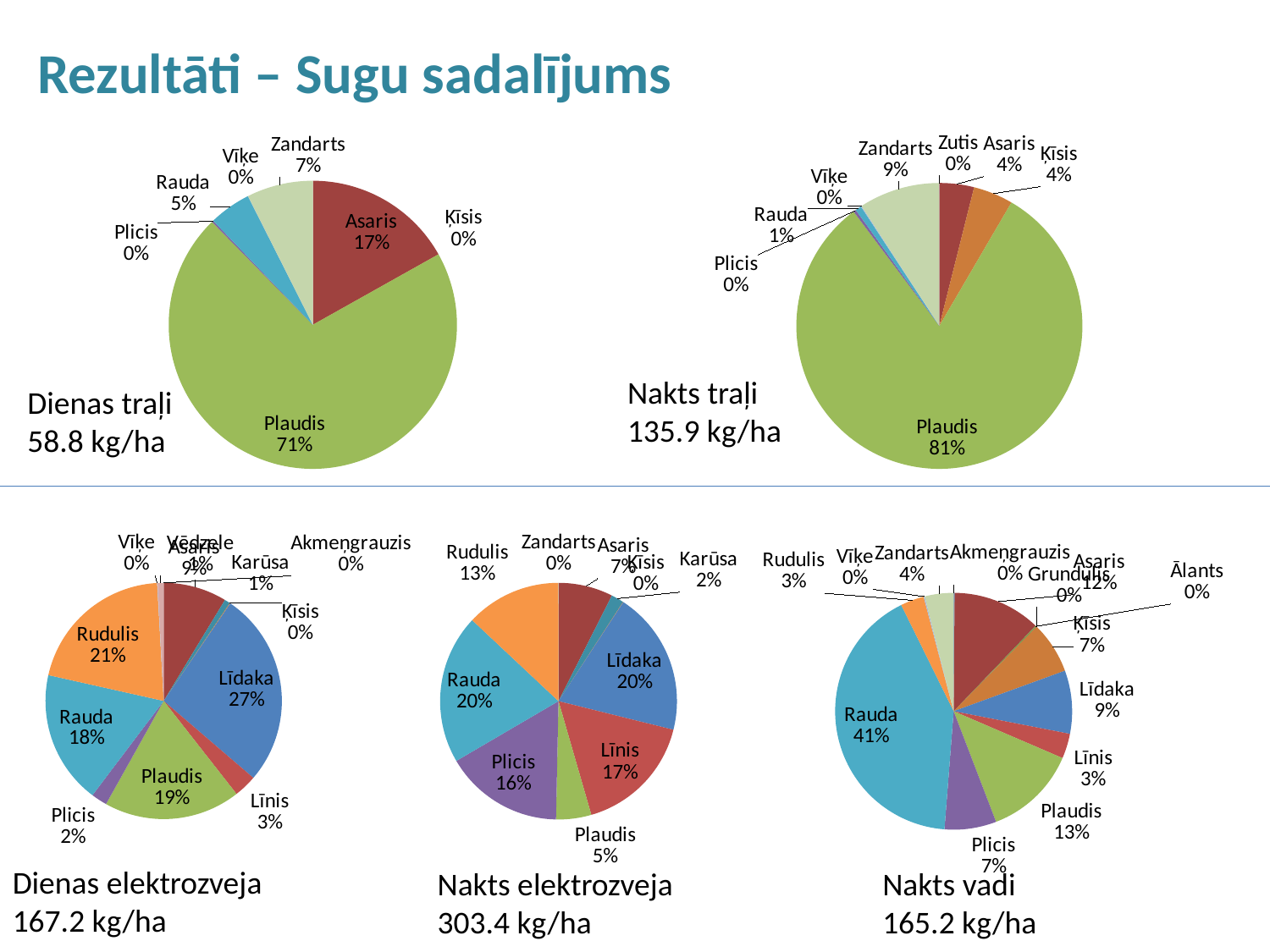
What kind of charts are shown on the slide? Pie charts What total catch in kg/ha is given for 'Nakts elektrozveja'? 303.4 kg/ha In the 'Dienas elektrozveja' pie chart, what is the difference between the shares of Rudulis and Rauda? 3% In the 'Dienas elektrozveja' pie chart, which species has the largest share? Līdaka In the 'Nakts vadi' pie chart, what share does Rauda have? 41% In the 'Nakts traļi' pie chart, what is the share of Zandarts? 9% In the 'Nakts elektrozveja' pie chart, what share does Plicis have? 16% In the 'Nakts elektrozveja' pie chart, which is larger, the share of Līnis or the share of Plaudis? Līnis In the 'Nakts vadi' pie chart, what is the difference between the shares of Plaudis and Līdaka? 4% In the 'Dienas traļi' pie chart, what share does Asaris have? 17% In the 'Dienas traļi' pie chart, what share does Plaudis have? 71% In the 'Nakts traļi' pie chart, which species has the largest share? Plaudis